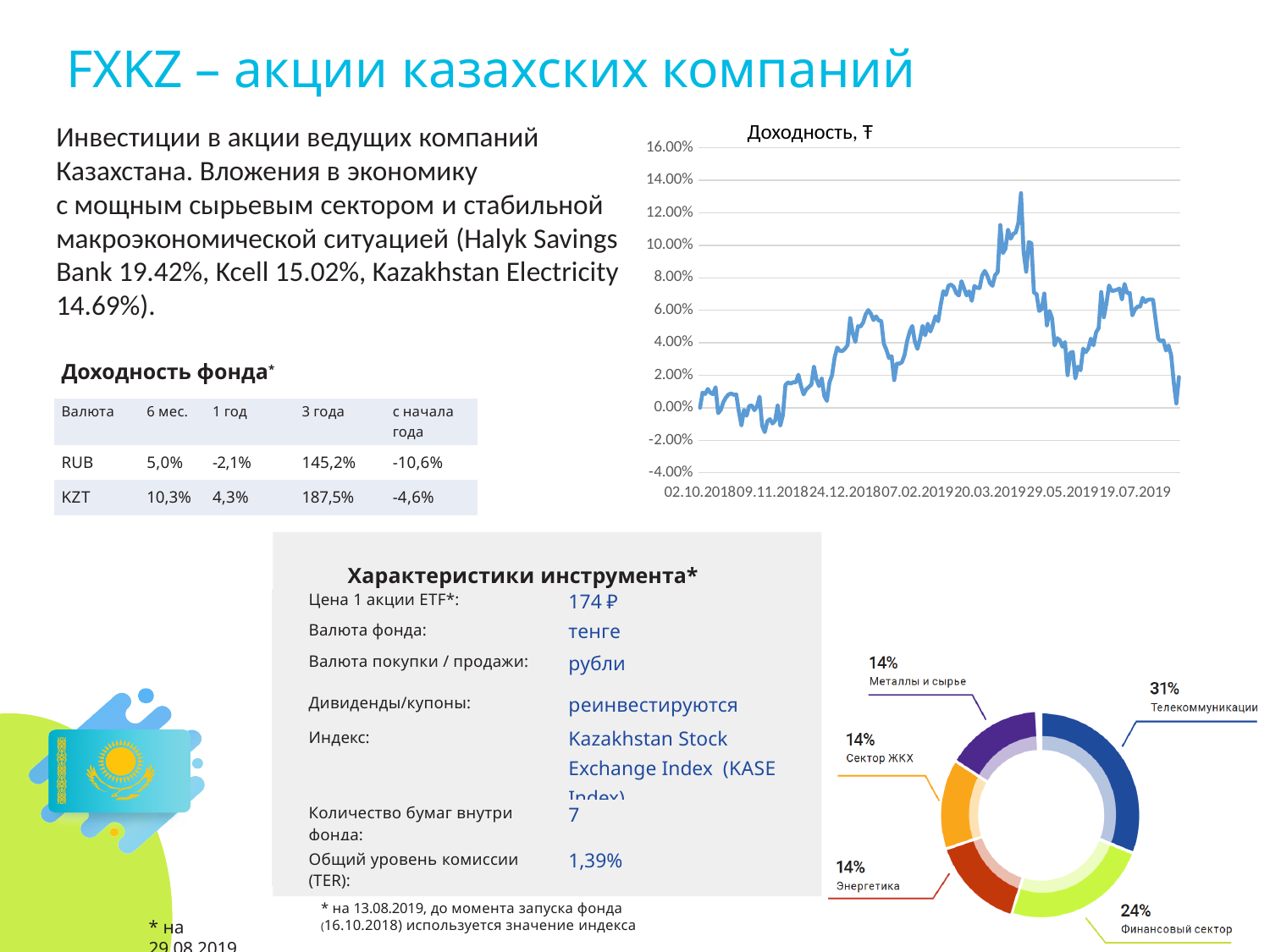
In the donut chart at the bottom right, which is larger: Энергетика or Финансовый сектор? Финансовый сектор In the donut chart at the bottom right, how many sectors are shown? 5 In the donut chart at the bottom right, what share does Финансовый сектор have? 24% In the donut chart at the bottom right, what share does Телекоммуникации have? 31% In the chart titled 'Доходность, ₸', is the lowest value of the line greater or less than 0.00%? less In the donut chart at the bottom right, which sector has the largest share? Телекоммуникации In the chart titled 'Доходность, ₸', does the line generally rise or fall between 02.10.2018 and 07.02.2019? rise In the chart titled 'Доходность, ₸', what is the highest value shown on the y axis? 16.00% What kind of chart is the chart titled 'Доходность, ₸'? line chart In the chart titled 'Доходность, ₸', what is the first date shown on the x axis? 02.10.2018 In the chart titled 'Доходность, ₸', is the peak value of the line greater or less than 12.00%? greater In the donut chart at the bottom right, what is the difference in percentage points between Телекоммуникации and Финансовый сектор? 7